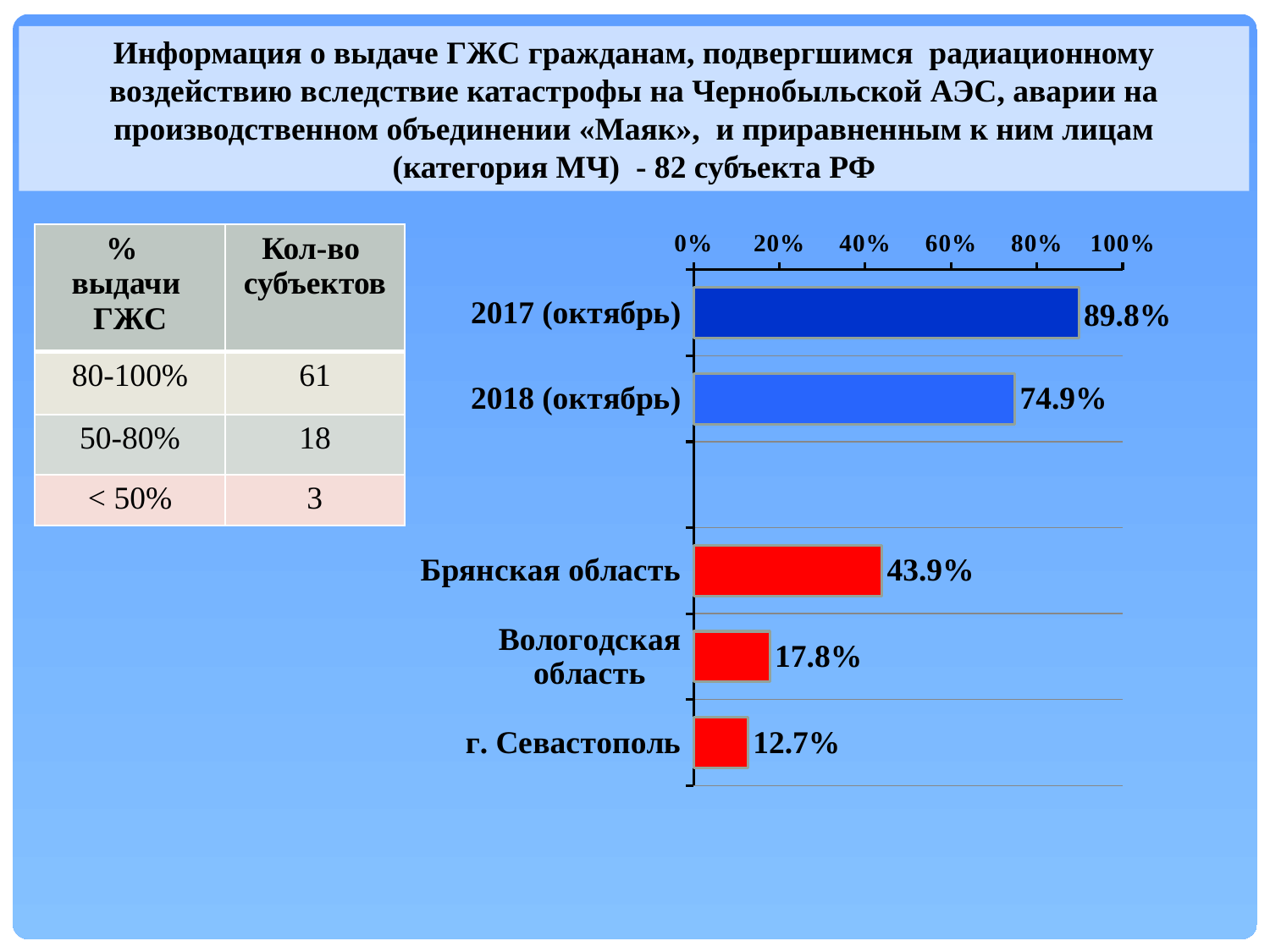
Which category has the lowest value in the chart? г. Севастополь Which is larger, the value for Брянская область or the value for Вологодская область? Брянская область What is the difference between the values for 2017 (октябрь) and 2018 (октябрь)? 14.9% Is the value for Брянская область greater or less than 40%? greater What is the value shown for 2017 (октябрь)? 89.8% What is the value shown for г. Севастополь? 12.7% How many labelled bars are plotted in the chart? 5 Which category has the highest value in the chart? 2017 (октябрь) What is the value shown for 2018 (октябрь)? 74.9% What is the value shown for Вологодская область? 17.8% What is the value shown for Брянская область? 43.9% What kind of chart is shown on the slide? bar chart